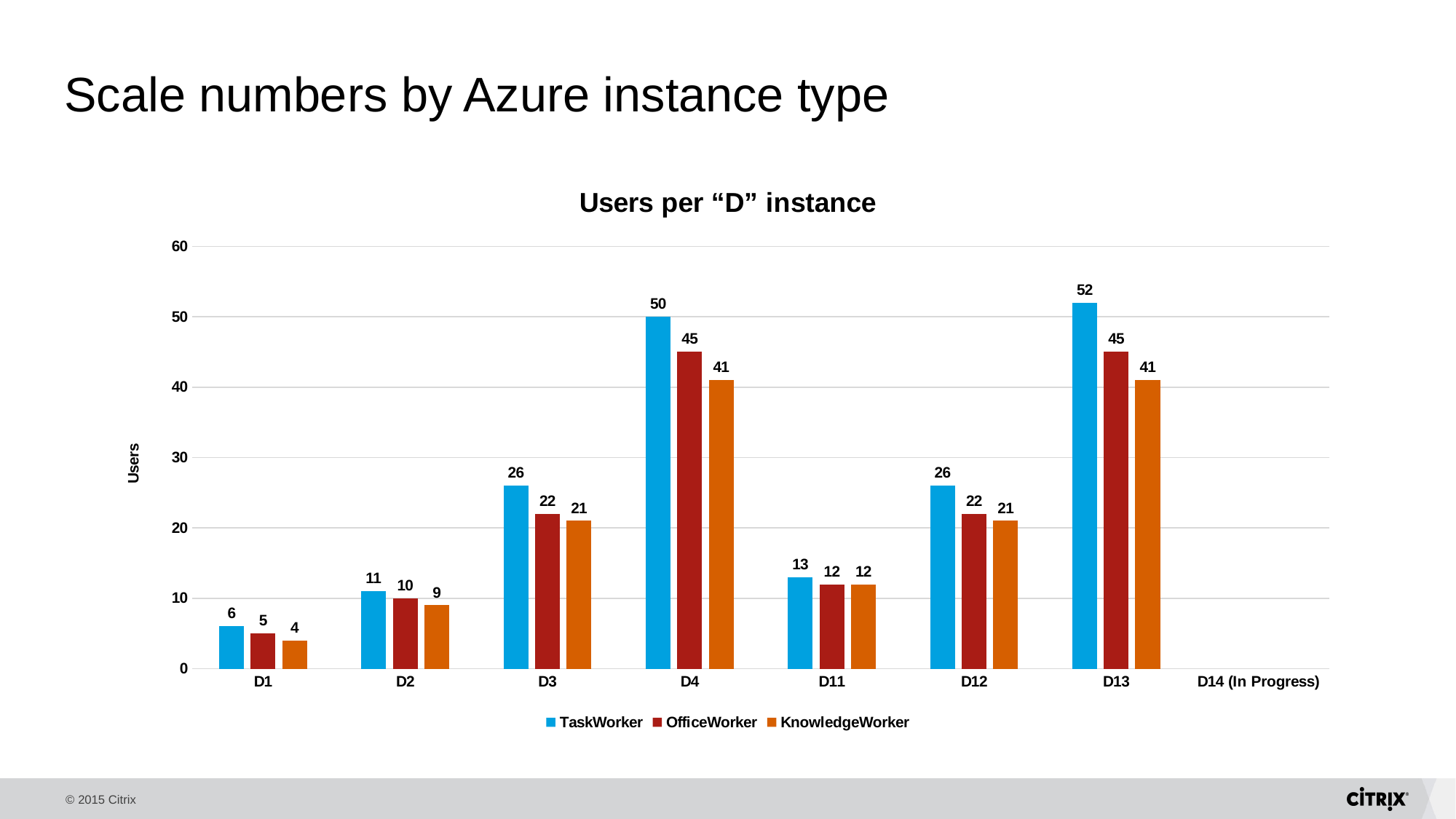
Which instance type has the lowest KnowledgeWorker value? D1 What is the OfficeWorker value for D11? 12 How many series does the legend list? 3 Which is larger, the OfficeWorker value for D12 or the OfficeWorker value for D11? D12 What is the TaskWorker value for D4? 50 What is the difference between the TaskWorker values for D13 and D4? 2 What kind of chart is shown on the slide? bar chart Which instance type has the highest TaskWorker value? D13 What is the title of the chart? Users per "D" instance What is the KnowledgeWorker value for D2? 9 Is the TaskWorker value for D13 greater or less than 50? greater What is the difference between the TaskWorker and KnowledgeWorker values for D3? 5